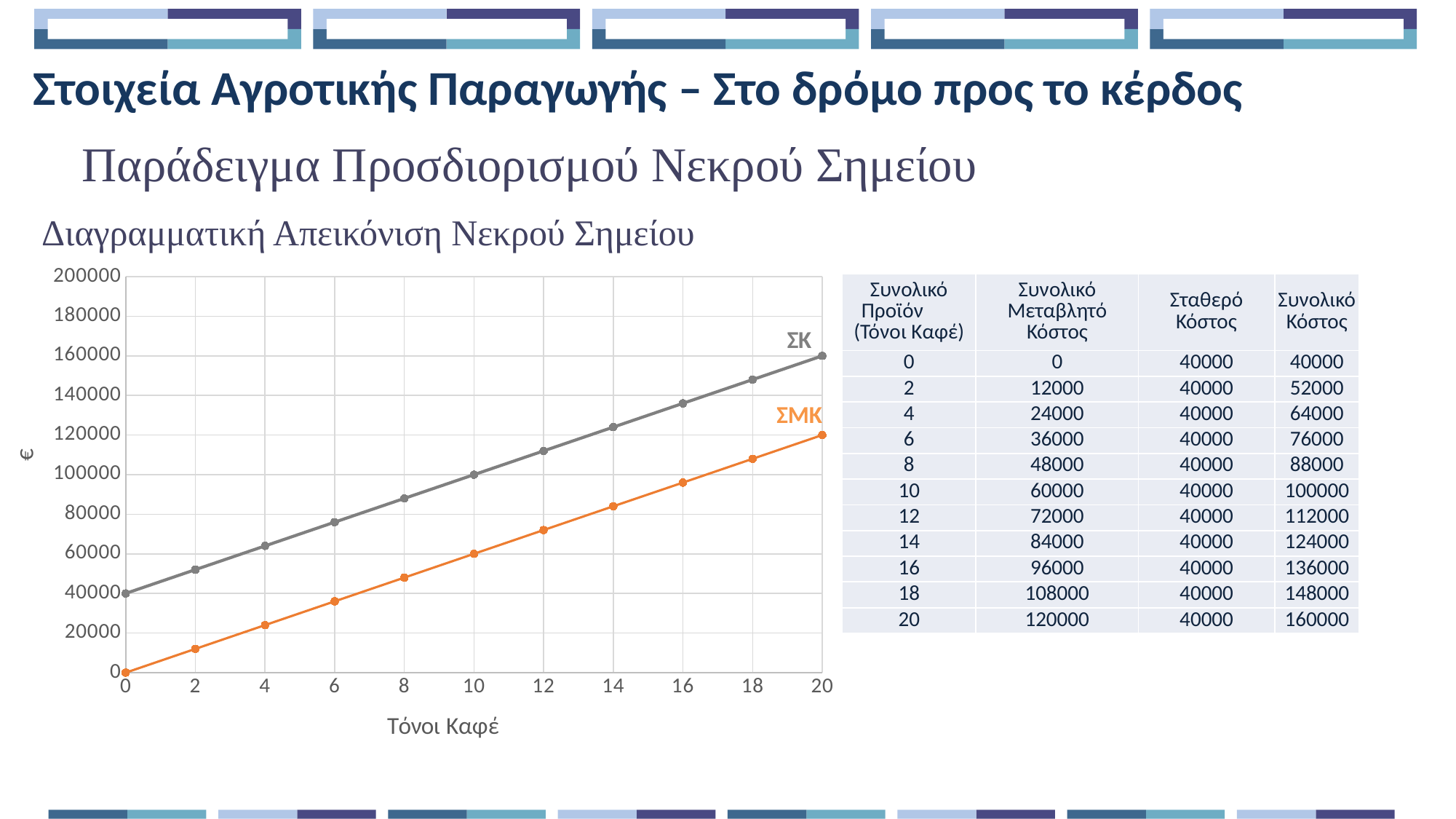
Is the value of ΣΜΚ at 18 Τόνοι Καφέ greater or less than 100000? greater What kind of chart is shown on the slide? line chart What is the label of the x axis of the chart? Τόνοι Καφέ What is the difference between ΣΚ and ΣΜΚ at 14 Τόνοι Καφέ? 40000 Do the values of ΣΜΚ rise or fall as Τόνοι Καφέ increases? rise What is the value of ΣΜΚ at 10 Τόνοι Καφέ? 60000 What colour is the ΣΜΚ line in the chart? orange What is the value of ΣΚ at 0 Τόνοι Καφέ? 40000 How many series are plotted in the chart? 2 What is the value of ΣΚ at 20 Τόνοι Καφέ? 160000 How many data points does each line in the chart have? 11 Which line is higher at 8 Τόνοι Καφέ, ΣΚ or ΣΜΚ? ΣΚ